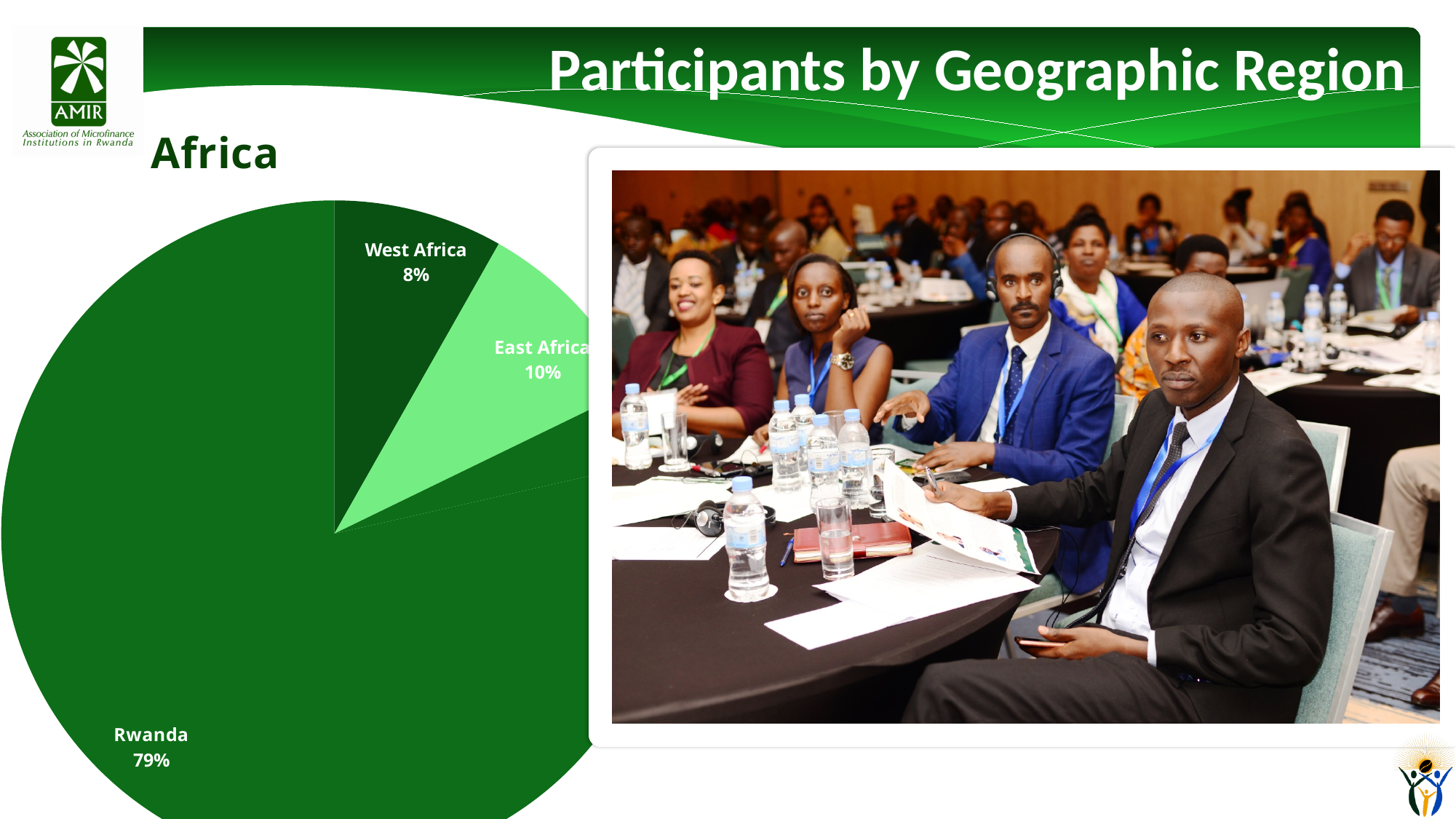
What is the title of the slide? Participants by Geographic Region What kind of chart is used to show participants by geographic region? Pie chart What percentage is shown for East Africa in the Africa pie chart? 10% What percentage is shown for West Africa in the Africa pie chart? 8% What is the difference in percentage points between the East Africa slice and the West Africa slice? 2 Which labelled region has the largest slice in the Africa pie chart? Rwanda Which has the smaller slice in the Africa pie chart, East Africa or West Africa? West Africa What is the title of the chart on the slide? Africa What is the difference in percentage points between the Rwanda slice and the East Africa slice? 69 Which is larger in the Africa pie chart, Rwanda or East Africa? Rwanda What share of participants does the Rwanda slice represent in the Africa pie chart? 79%